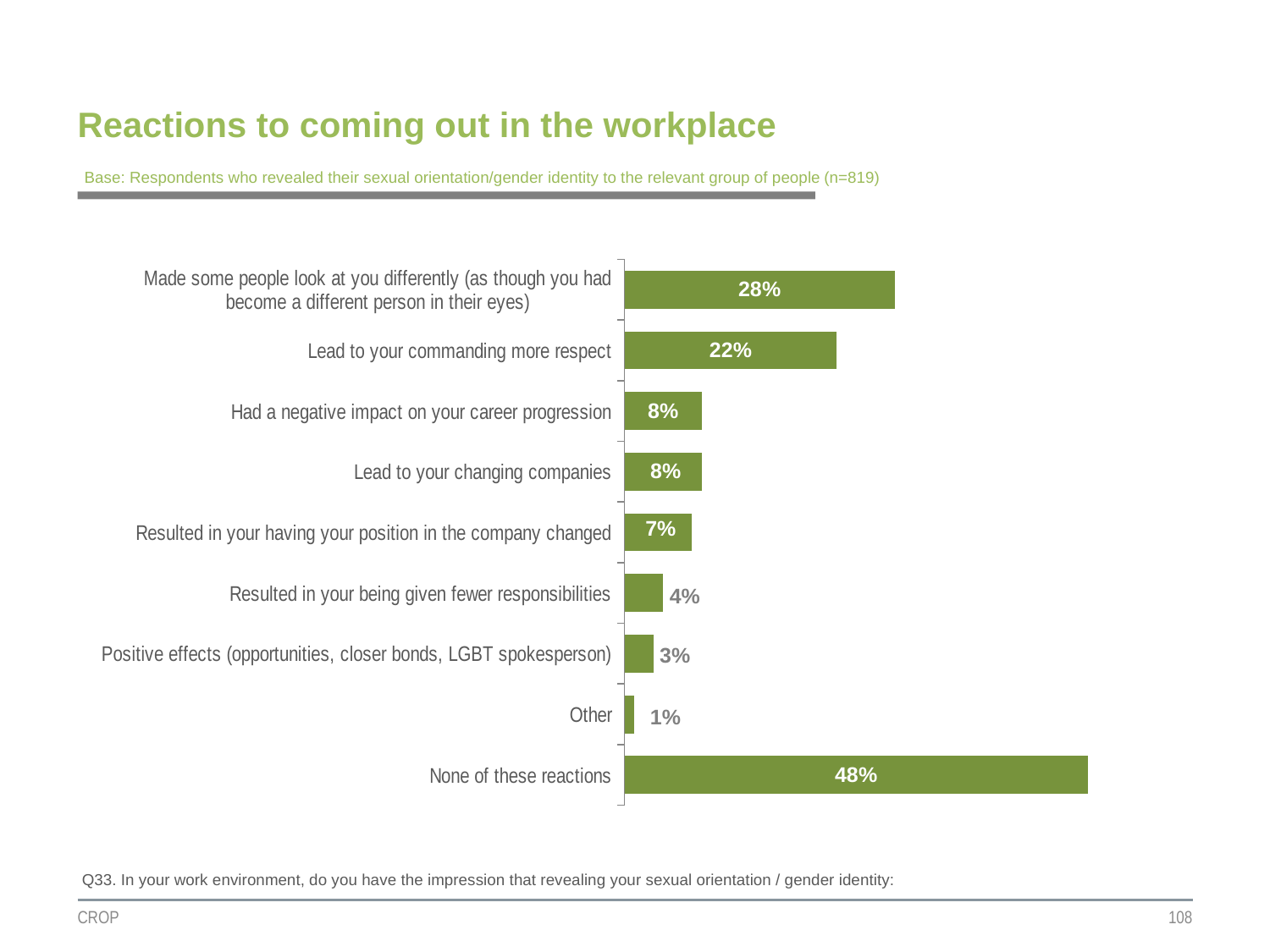
Which is larger: 'Resulted in your being given fewer responsibilities' or 'Positive effects (opportunities, closer bonds, LGBT spokesperson)'? Resulted in your being given fewer responsibilities Which category has the highest value? None of these reactions Which category has the lowest value? Other What kind of chart is shown on the slide? Bar chart What percentage said coming out had a negative impact on their career progression? 8% What is the difference between 'Made some people look at you differently' and 'Lead to your commanding more respect'? 6% What is the title of the chart on the slide? Reactions to coming out in the workplace What percentage of respondents said coming out lead to their commanding more respect? 22% What is the value for 'Other'? 1% What is the difference between 'None of these reactions' and 'Made some people look at you differently'? 20% What is the value for 'None of these reactions'? 48% How many categories are shown in the chart? 9